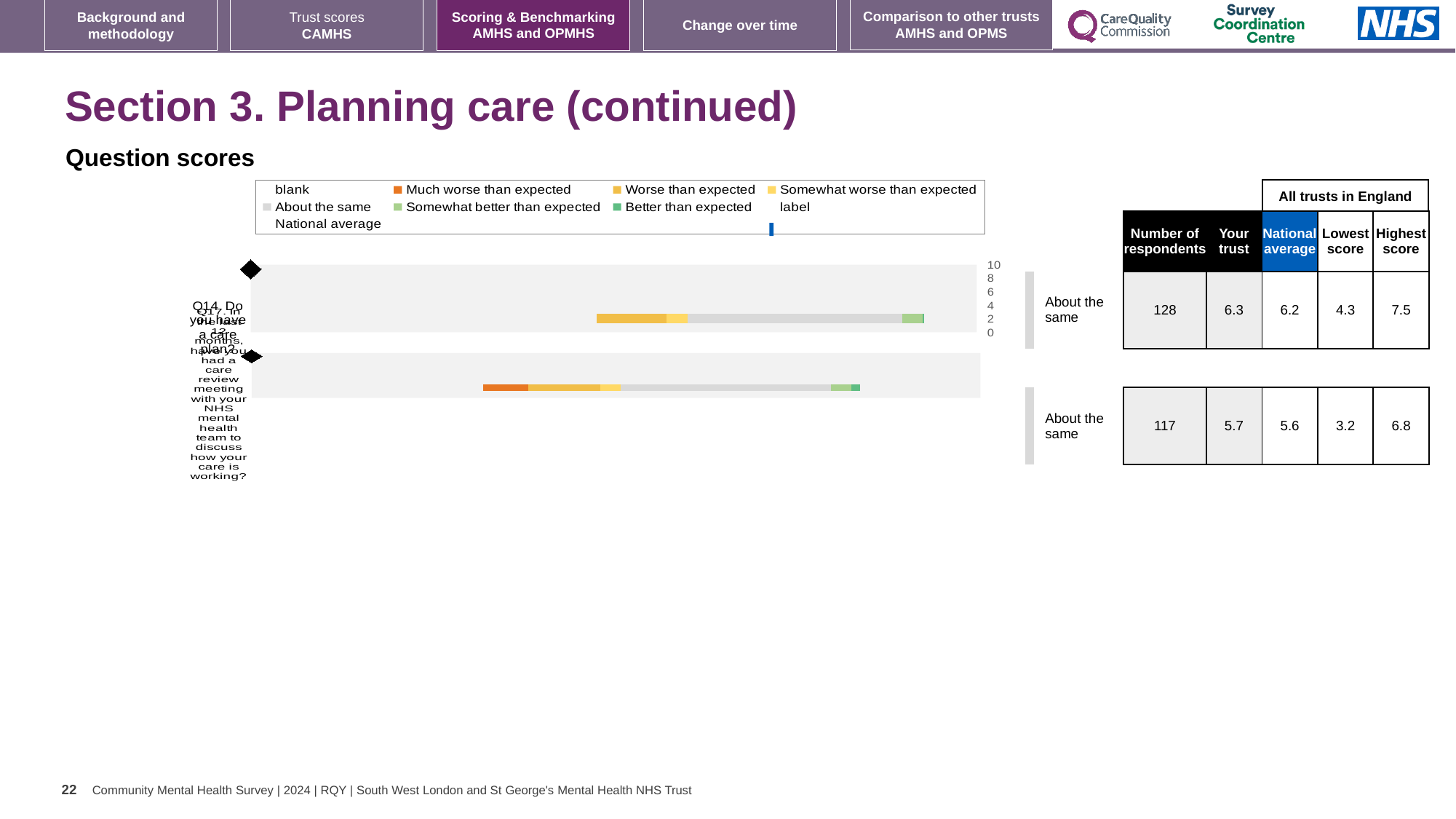
What is the 'Your trust' score shown for Q14 (Do you have a care plan?)? 6.3 How many questions are plotted as bars in the question scores chart? 2 What is the national average score shown for Q17 (care review meeting in the last 12 months)? 5.6 What kind of chart is used to show the question scores on this slide? bar chart For Q14, what is the difference between the highest score and the lowest score among all trusts in England? 3.2 In the chart legend, which colour represents 'Much worse than expected'? orange What is the lowest score among all trusts in England shown for Q17? 3.2 In the chart legend, which colour represents 'Better than expected'? green What benchmark category is shown next to the bar for Q17? About the same What is the number of respondents shown for Q14 (Do you have a care plan?)? 128 What is the highest score among all trusts in England shown for Q14? 7.5 For Q14, which is larger: the 'Your trust' score or the national average? Your trust